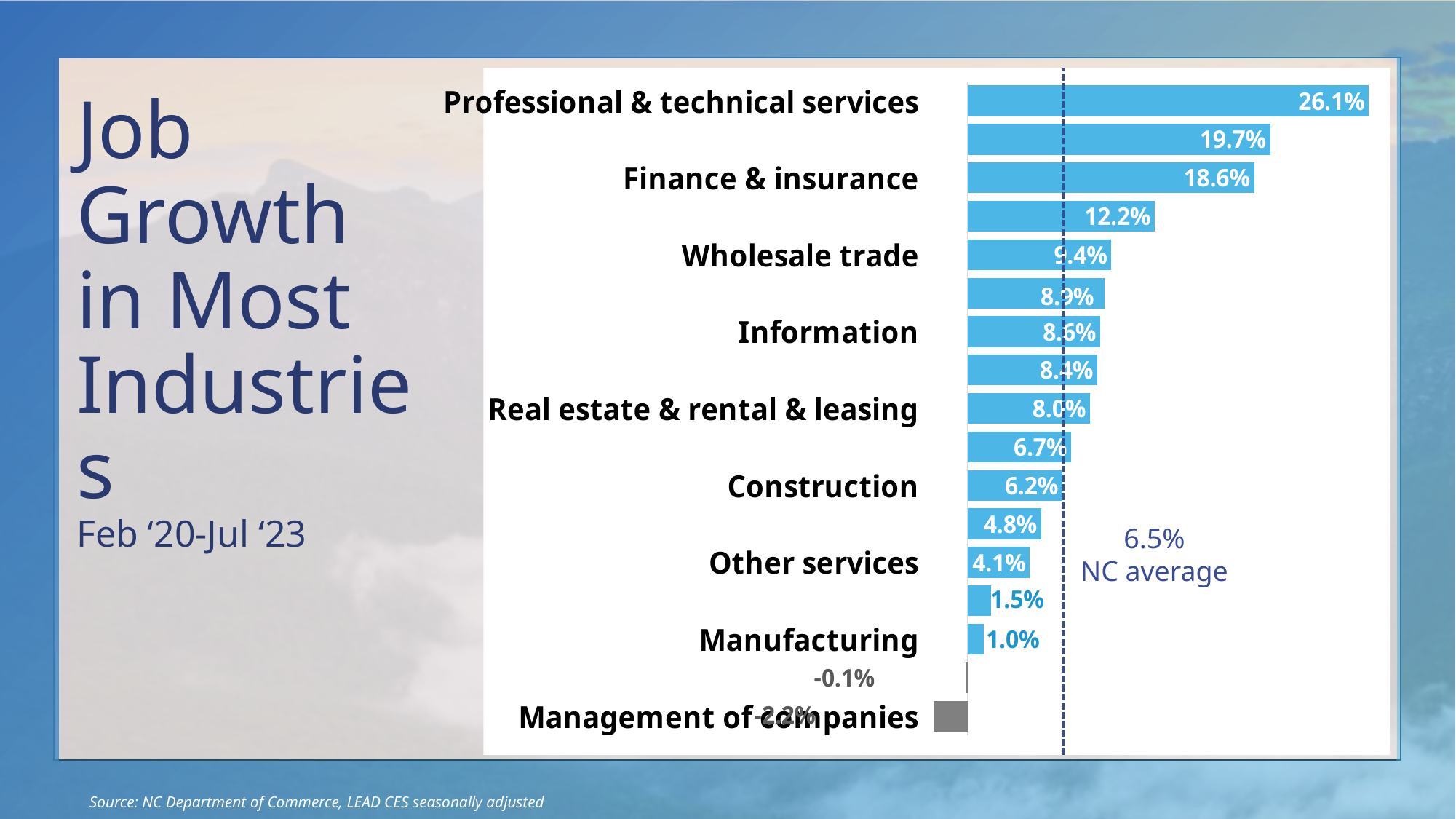
What is the job growth value for Professional & technical services? 26.1% How many bars are plotted in the chart? 17 What is the job growth value for Finance & insurance? 18.6% What is the job growth value for Wholesale trade? 9.4% What is the difference in job growth between Professional & technical services and Finance & insurance? 7.5 percentage points What kind of chart is shown on the slide? Bar chart What is the job growth value for Manufacturing? 1.0% Which has higher job growth, Information or Other services? Information What NC average value is marked by the dashed line on the chart? 6.5% Which industry has the lowest job growth? Management of companies Which industry has the highest job growth? Professional & technical services What is the job growth value for Construction? 6.2%